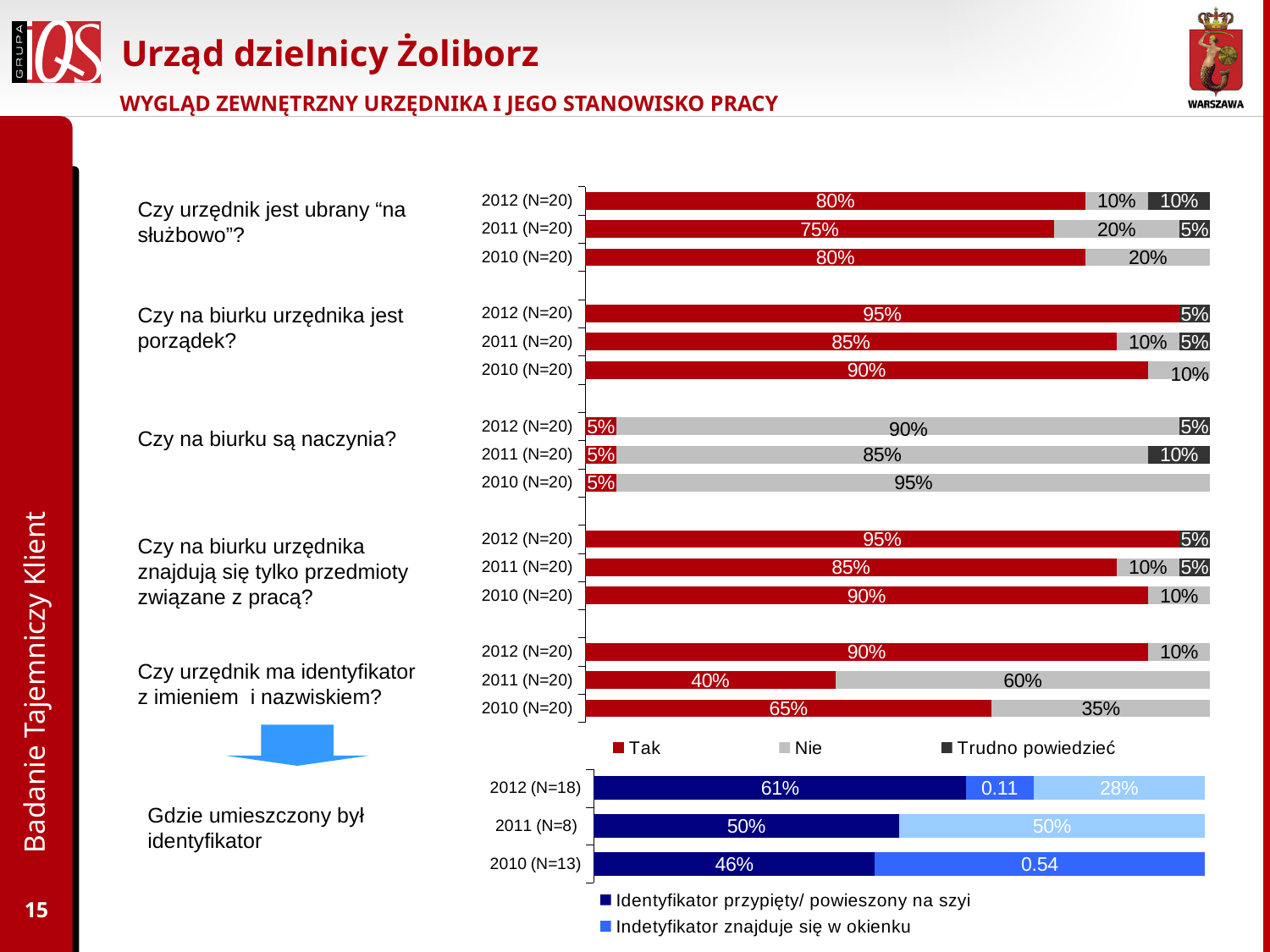
In the upper chart, what is the "Nie" value for "Czy urzędnik jest ubrany 'na służbowo'?" in 2011 (N=20)? 20% In the lower chart (Gdzie umieszczony był identyfikator), what is the value of the last segment for 2010 (N=13)? 0.54 In the upper chart, what is the difference between the "Tak" values for "Czy urzędnik ma identyfikator z imieniem i nazwiskiem?" in 2012 (N=20) and 2011 (N=20)? 50% How many year categories are shown in the lower chart (Gdzie umieszczony był identyfikator)? 3 In the upper chart, what percentage answered "Tak" to "Czy urzędnik jest ubrany 'na służbowo'?" in 2012 (N=20)? 80% How many series does the legend of the upper chart list? 3 In the upper chart, for "Czy urzędnik ma identyfikator z imieniem i nazwiskiem?", which year has the highest "Tak" value? 2012 (N=20) In the lower chart (Gdzie umieszczony był identyfikator), what is the value of the first segment for 2012 (N=18)? 61% In the upper chart, for "Czy na biurku urzędnika jest porządek?", is the "Tak" value larger in 2012 (N=20) or 2011 (N=20)? 2012 (N=20) In the upper chart, what is the "Tak" value for "Czy urzędnik ma identyfikator z imieniem i nazwiskiem?" in 2011 (N=20)? 40% What type of chart is the upper chart? Stacked bar chart In the upper chart, for "Czy na biurku są naczynia?", what is the "Nie" value in 2010 (N=20)? 95%